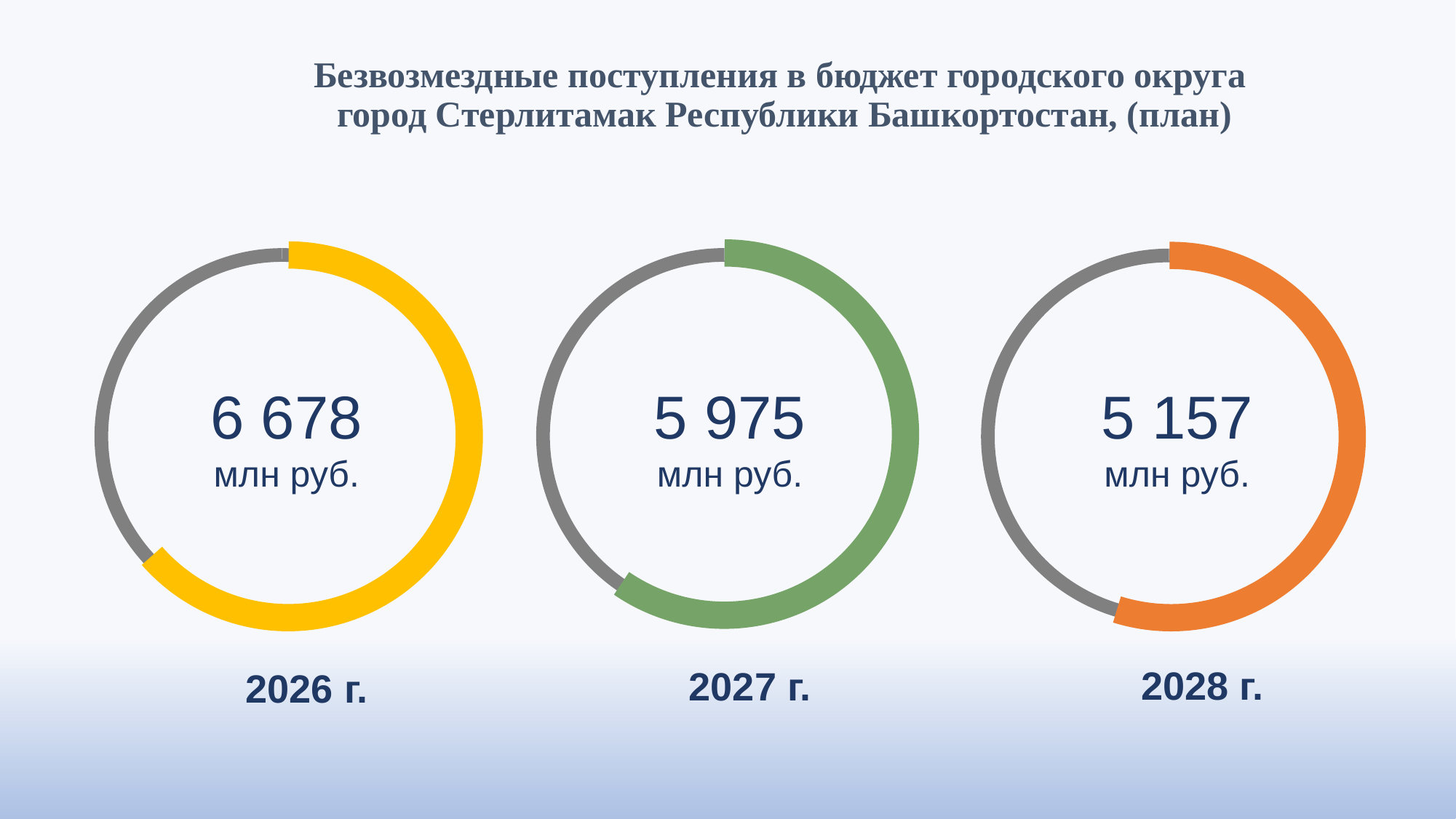
What colour is the ring for 2027 г.? green Which is larger, the planned value for 2027 г. or for 2028 г.? 2027 г. What is the difference between the planned values for 2027 г. and 2028 г.? 818 млн руб. Do the planned values rise or fall from 2026 г. to 2028 г.? fall How many years are shown on the slide? 3 Which year has the lowest planned value of gratuitous receipts? 2028 г. What is the planned value of gratuitous receipts for 2027 г.? 5 975 млн руб. What is the planned value of gratuitous receipts for 2028 г.? 5 157 млн руб. What is the difference between the planned values for 2026 г. and 2028 г.? 1 521 млн руб. What is the planned value of gratuitous receipts for 2026 г.? 6 678 млн руб. Which year has the highest planned value of gratuitous receipts? 2026 г. By how much does the planned value for 2026 г. exceed the value for 2027 г.? 703 млн руб.